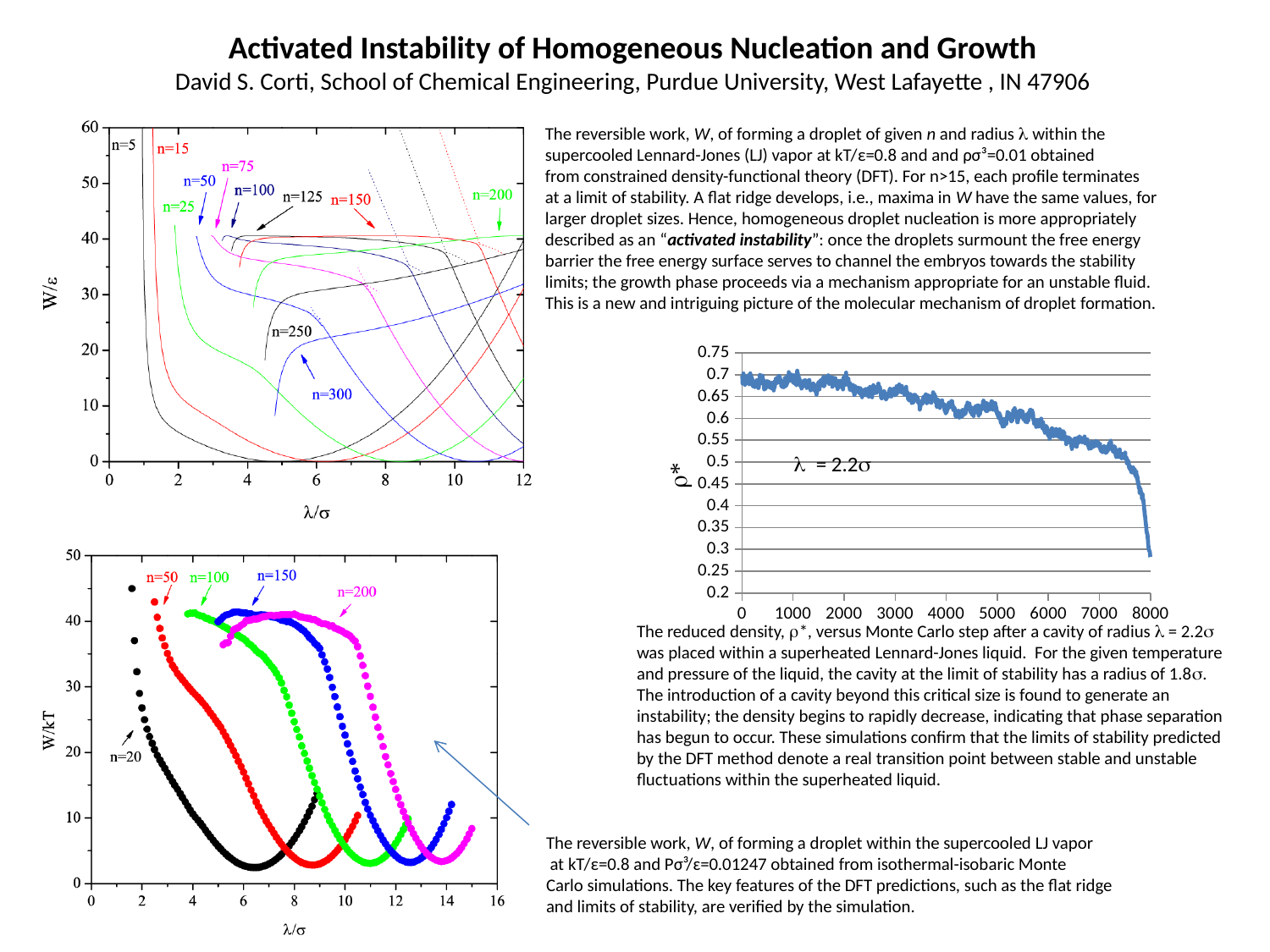
What kind of chart is the chart on the right showing ρ* versus Monte Carlo step? line chart In the bottom-left chart (W/kT versus λ/σ), is the minimum W/kT of the n=20 series greater or less than 10? less In the chart on the right (ρ* versus Monte Carlo step), is the value of ρ* at step 7000 greater or less than 0.6? less In the top-left chart (W/ε versus λ/σ), is the maximum W/ε of the n=50 profile greater or less than 30? greater In the top-left chart (W/ε versus λ/σ), how many labeled n profiles are shown? 11 In the chart on the right (ρ* versus Monte Carlo step), what is the maximum value shown on the x axis? 8000 In the bottom-left chart (W/kT versus λ/σ), which series has its minimum at a larger λ/σ, n=50 or n=200? n=200 In the chart on the right (ρ* versus Monte Carlo step), what cavity radius is annotated on the plot? λ = 2.2σ In the bottom-left chart (W/kT versus λ/σ), how many labeled n series are plotted? 5 In the chart on the right (ρ* versus Monte Carlo step), does ρ* rise or fall as the Monte Carlo step increases? fall In the bottom-left chart (W/kT versus λ/σ), which labeled series reaches the highest W/kT value? n=20